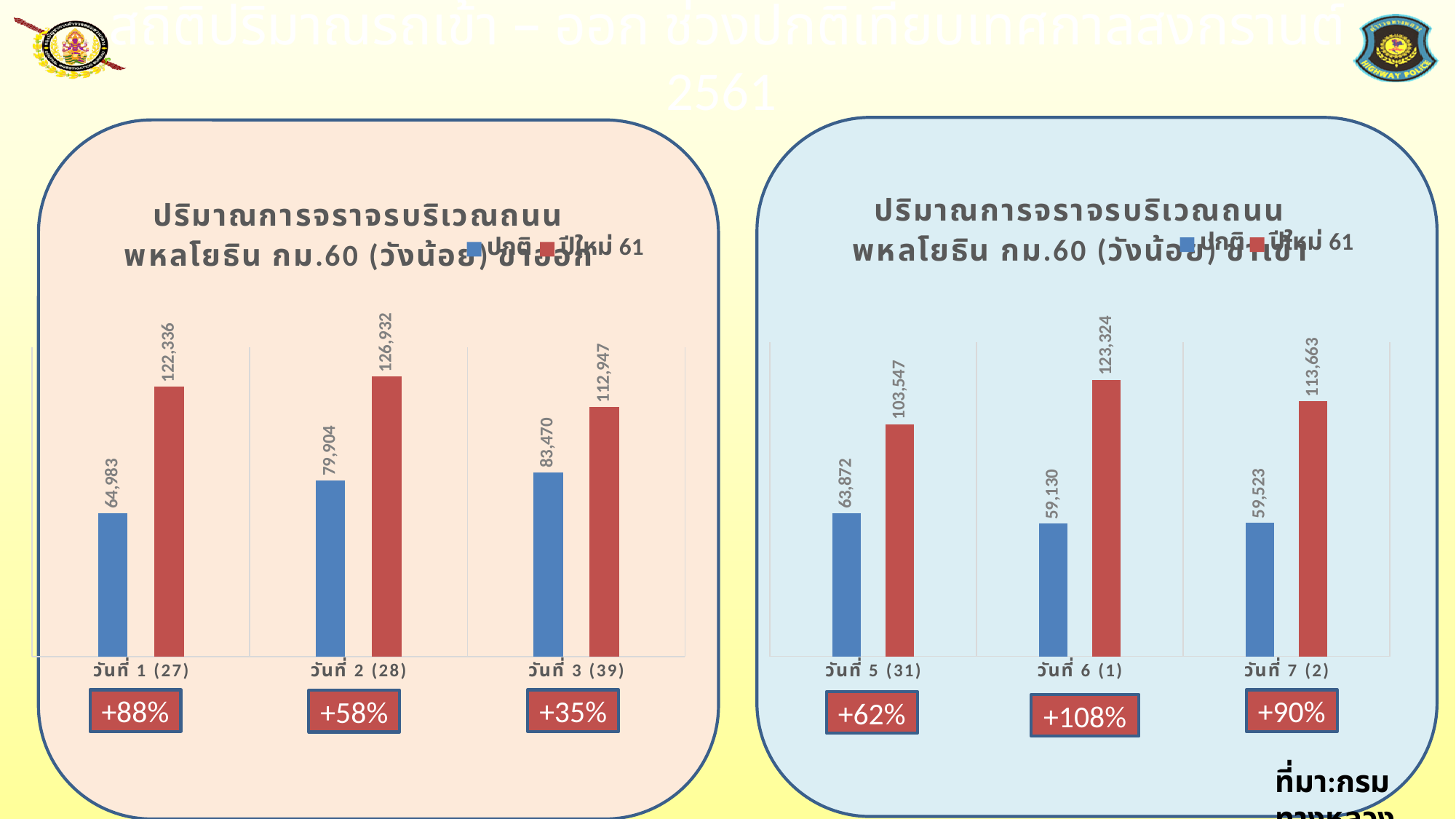
In the right chart, which is larger: the ปีใหม่ 61 value for วันที่ 6 (1) or for วันที่ 7 (2)? วันที่ 6 (1) In the right chart, what is the ปีใหม่ 61 value for วันที่ 6 (1)? 123,324 In the left chart, what is the ปีใหม่ 61 value for วันที่ 2 (28)? 126,932 In the left chart, which category has the highest ปีใหม่ 61 value? วันที่ 2 (28) In the left chart, what is the difference between the ปีใหม่ 61 and ปกติ values for วันที่ 3 (39)? 29,477 What type of chart is the left chart? Bar chart How many categories are shown on the x axis of the left chart? 3 In the right chart, which category has the lowest ปกติ value? วันที่ 6 (1) How many series does the legend of the right chart list? 2 In the right chart, what is the difference between the ปีใหม่ 61 and ปกติ values for วันที่ 5 (31)? 39,675 In the right chart, what is the ปกติ value for วันที่ 7 (2)? 59,523 In the left chart, what is the ปกติ value for วันที่ 1 (27)? 64,983